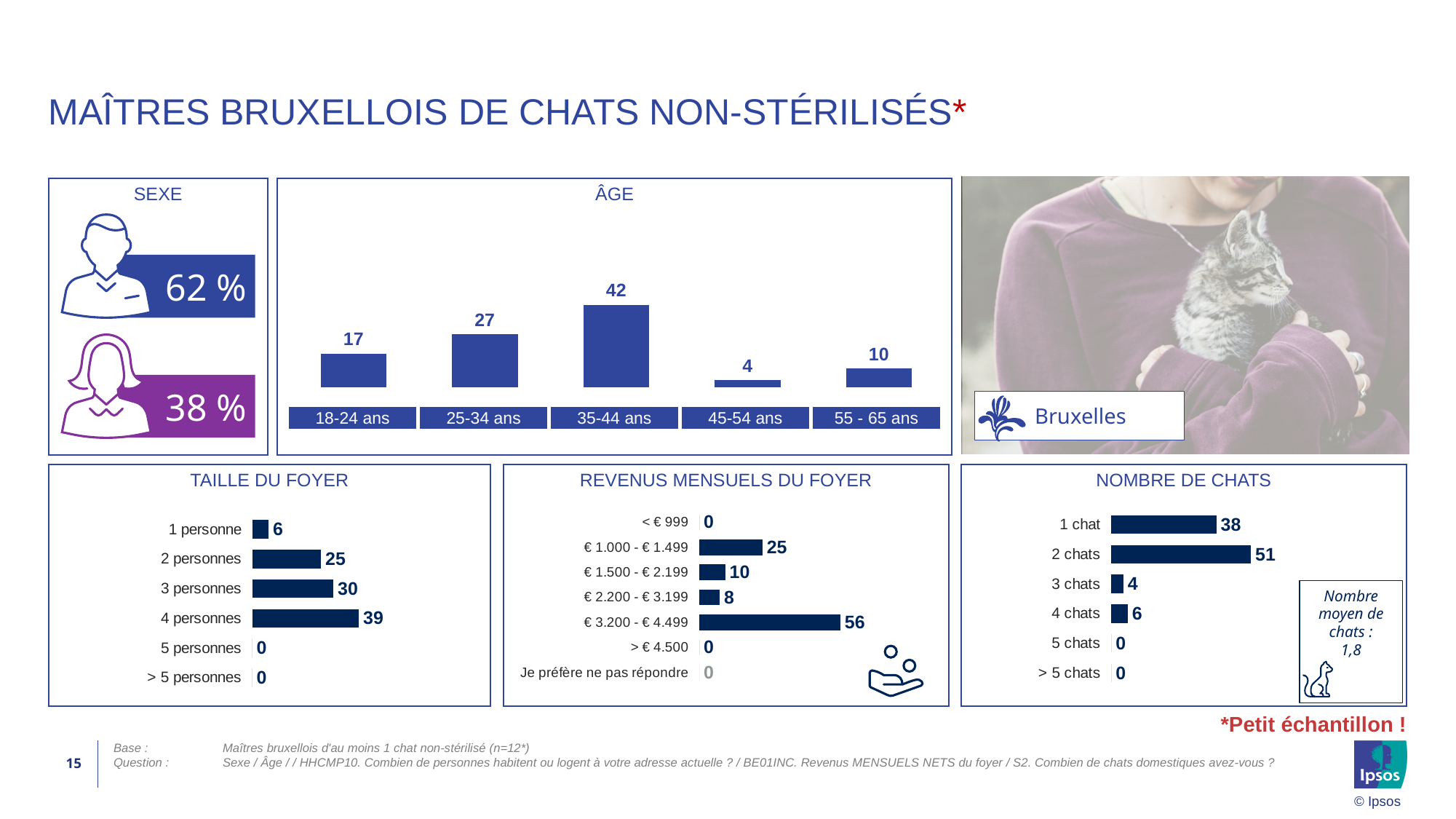
In the NOMBRE DE CHATS chart, what is the value for 2 chats? 51 In the TAILLE DU FOYER chart, what is the value for 2 personnes? 25 In the ÂGE chart, what is the difference between the values for 35-44 ans and 25-34 ans? 15 In the NOMBRE DE CHATS chart, what is the difference between the values for 2 chats and 1 chat? 13 In the REVENUS MENSUELS DU FOYER chart, what is the value for € 3.200 - € 4.499? 56 In the TAILLE DU FOYER chart, which category has the highest value? 4 personnes What kind of chart is the ÂGE chart? bar chart In the REVENUS MENSUELS DU FOYER chart, which is larger: € 1.000 - € 1.499 or € 1.500 - € 2.199? € 1.000 - € 1.499 In the ÂGE chart, which age group has the lowest value? 45-54 ans In the ÂGE chart, what is the value for 35-44 ans? 42 In the ÂGE chart, how many age categories are shown? 5 In the SEXE chart, what is the percentage shown for men? 62 %